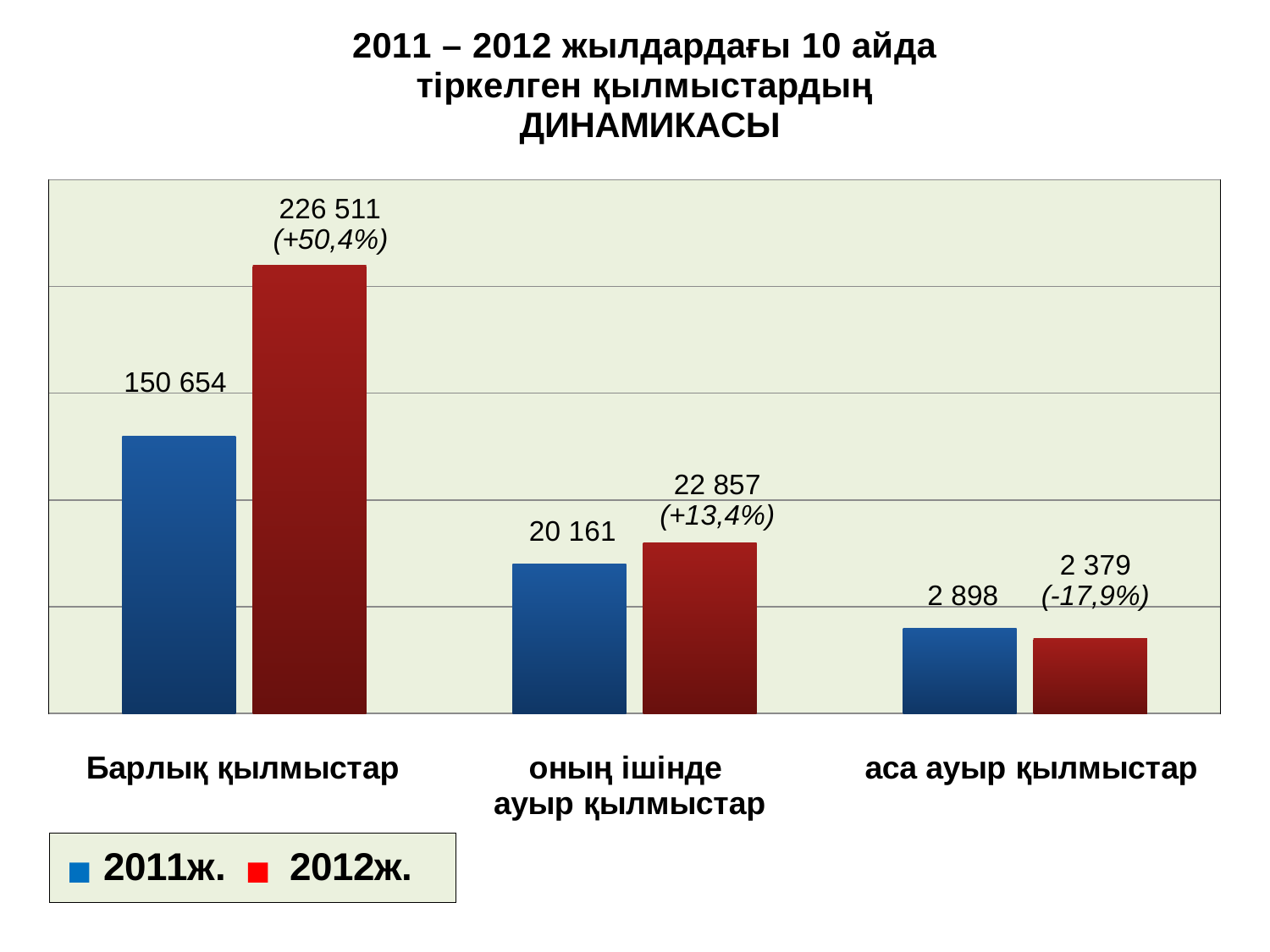
Which category has the highest 2012ж. value? Барлық қылмыстар For аса ауыр қылмыстар, which year has the larger value, 2011ж. or 2012ж.? 2011ж. What percentage change is shown next to the 2012ж. bar for аса ауыр қылмыстар? -17,9% What is the difference between the 2012ж. and 2011ж. values for Барлық қылмыстар? 75 857 What is the 2011ж. value for Барлық қылмыстар? 150 654 What is the difference between the 2011ж. and 2012ж. values for аса ауыр қылмыстар? 519 What is the 2012ж. value for Барлық қылмыстар? 226 511 What kind of chart is shown on the slide? bar chart Which category has the lowest 2011ж. value? аса ауыр қылмыстар What is the 2012ж. value for оның ішінде ауыр қылмыстар? 22 857 How many series does the legend list? 2 What is the 2011ж. value for аса ауыр қылмыстар? 2 898